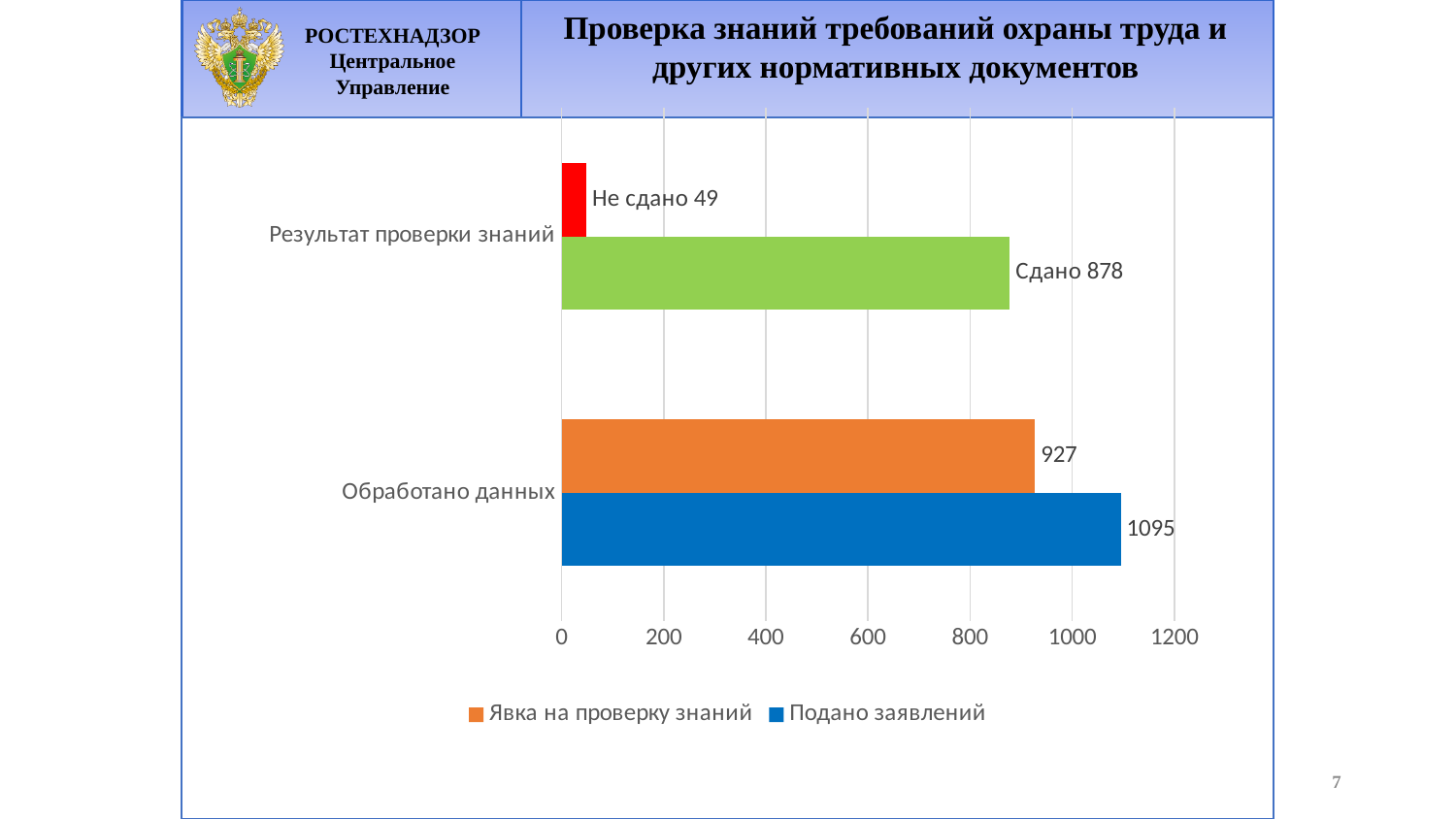
What value is labelled "Не сдано" in the "Результат проверки знаний" category? 49 What is the difference between "Подано заявлений" (1095) and "Явка на проверку знаний" (927)? 168 What value is shown for "Явка на проверку знаний" in the "Обработано данных" category? 927 What value is labelled "Сдано" in the "Результат проверки знаний" category? 878 Which bar on the chart has the highest value? Подано заявлений (1095) Is the value for "Сдано" greater or less than 1000? less What kind of chart is shown on the slide? Bar chart What is the difference between "Сдано" (878) and "Не сдано" (49)? 829 Which bar on the chart has the lowest value? Не сдано (49) What value is shown for "Подано заявлений" in the "Обработано данных" category? 1095 Which is larger: "Сдано" or "Явка на проверку знаний"? Явка на проверку знаний How many series does the legend list? 2